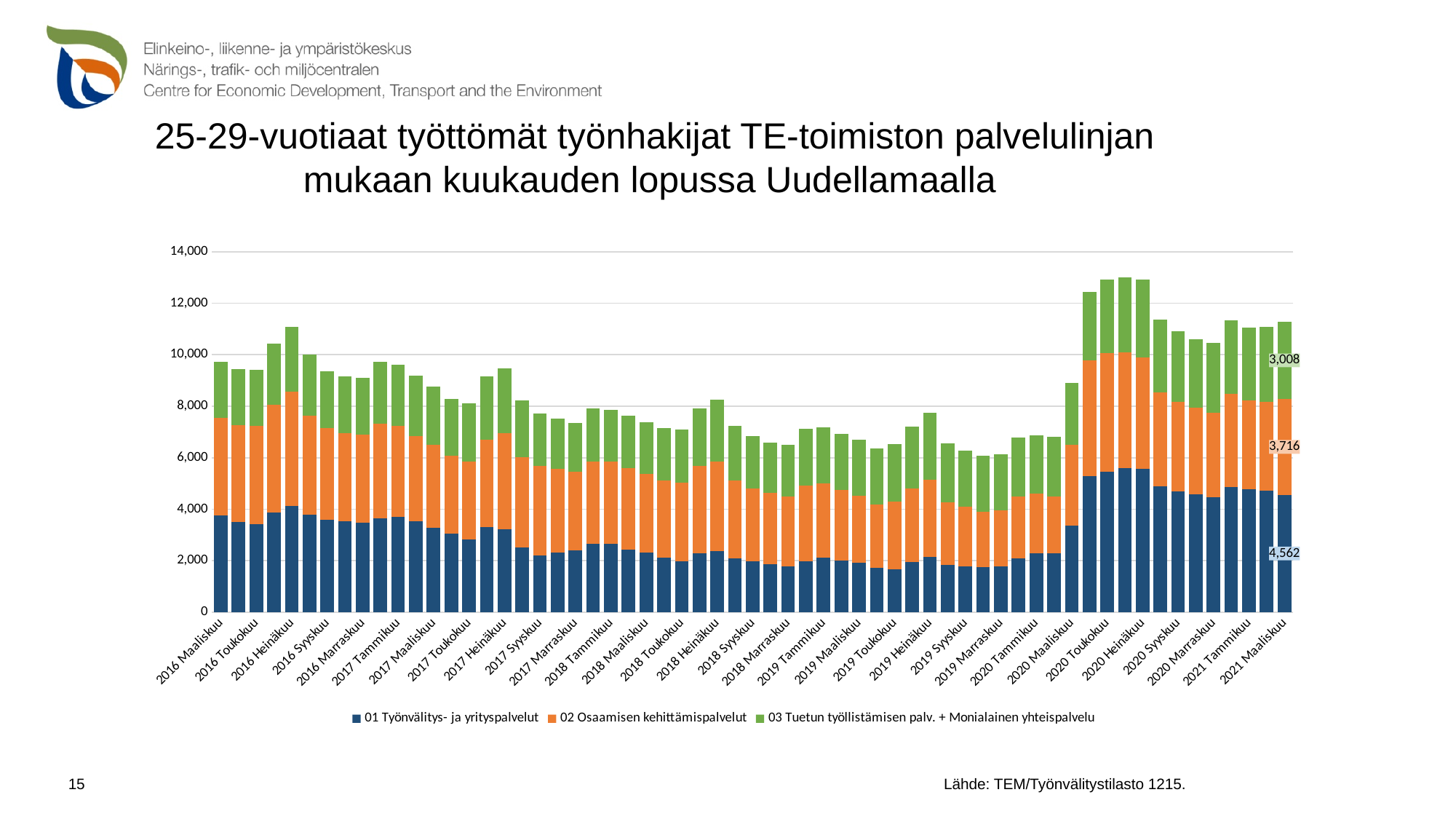
Is the total for 2019 Marraskuu greater or less than 8,000? less In 2021 Maaliskuu, what is the difference between 01 Työnvälitys- ja yrityspalvelut and 02 Osaamisen kehittämispalvelut? 846 Do the stacked totals rise or fall from 2020 Maaliskuu to 2020 Toukokuu? rise In 2021 Maaliskuu, which is larger: 01 Työnvälitys- ja yrityspalvelut or 03 Tuetun työllistämisen palv. + Monialainen yhteispalvelu? 01 Työnvälitys- ja yrityspalvelut What is the value for 02 Osaamisen kehittämispalvelut in 2021 Maaliskuu? 3,716 Is the total for 2020 Heinäkuu greater or less than 12,000? greater What kind of chart is shown on the slide? Stacked bar chart What is the value for 03 Tuetun työllistämisen palv. + Monialainen yhteispalvelu in 2021 Maaliskuu? 3,008 How many series does the legend list? 3 Which series is shown in green in the legend? 03 Tuetun työllistämisen palv. + Monialainen yhteispalvelu What is the value for 01 Työnvälitys- ja yrityspalvelut in 2021 Maaliskuu? 4,562 What is the total of the stacked bar for 2021 Maaliskuu? 11,286